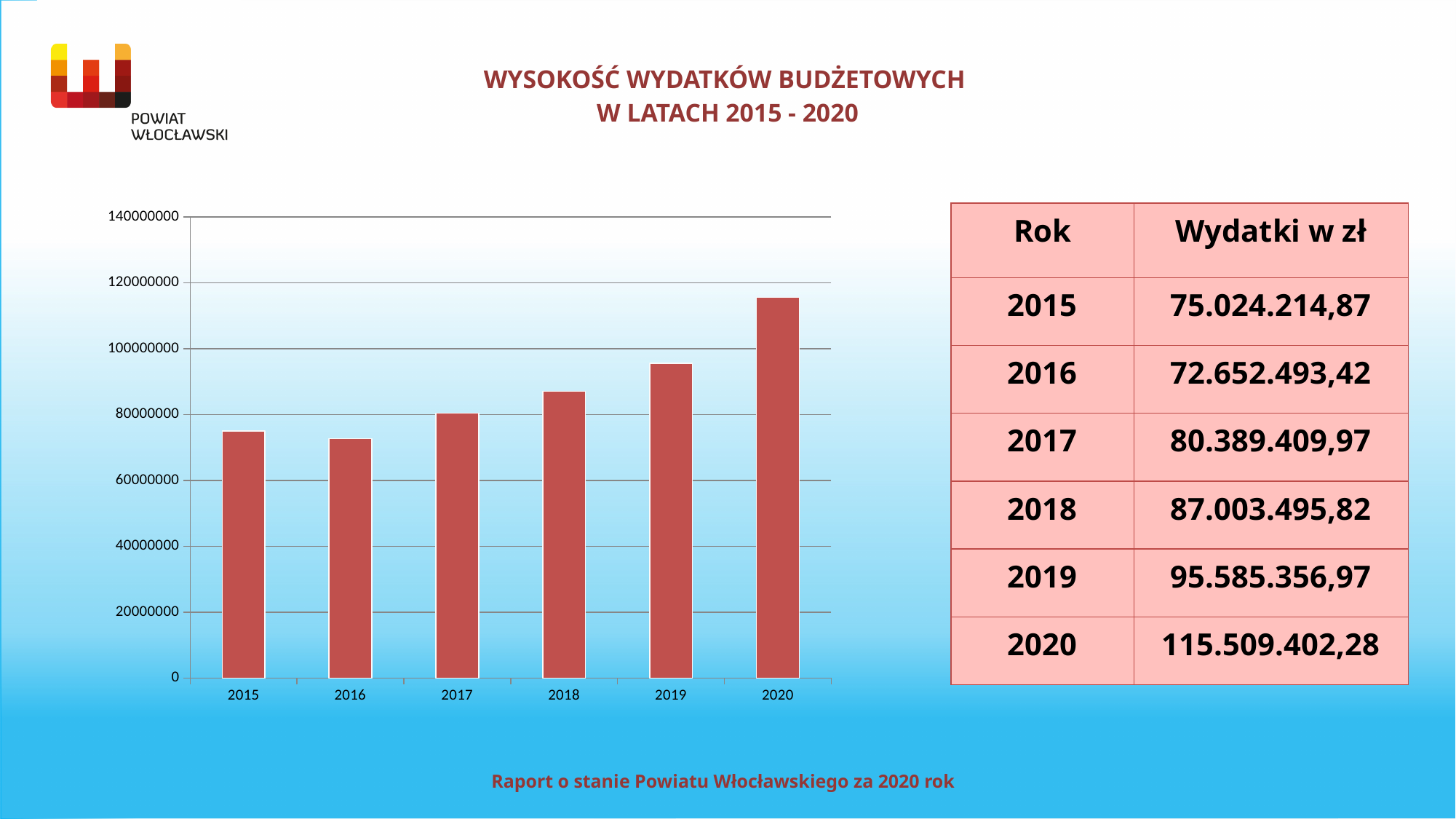
Which year has the lowest budget expenditure in the chart? 2016 What type of chart is shown on the slide? bar chart What is the title of the chart on the slide? WYSOKOŚĆ WYDATKÓW BUDŻETOWYCH W LATACH 2015 - 2020 Is the value for 2020 greater or less than 100000000? greater Is the value for 2019 greater or less than 100000000? less Do the values generally rise or fall from 2016 to 2020? rise How many years are plotted in the bar chart? 6 Which year has the highest budget expenditure in the chart? 2020 What is the expenditure value for 2018 according to the slide? 87.003.495,82 What is the expenditure value for 2020 according to the slide? 115.509.402,28 What is the difference between the expenditure in 2020 and in 2019? 19.924.045,31 Which is larger, the value for 2015 or the value for 2016? 2015